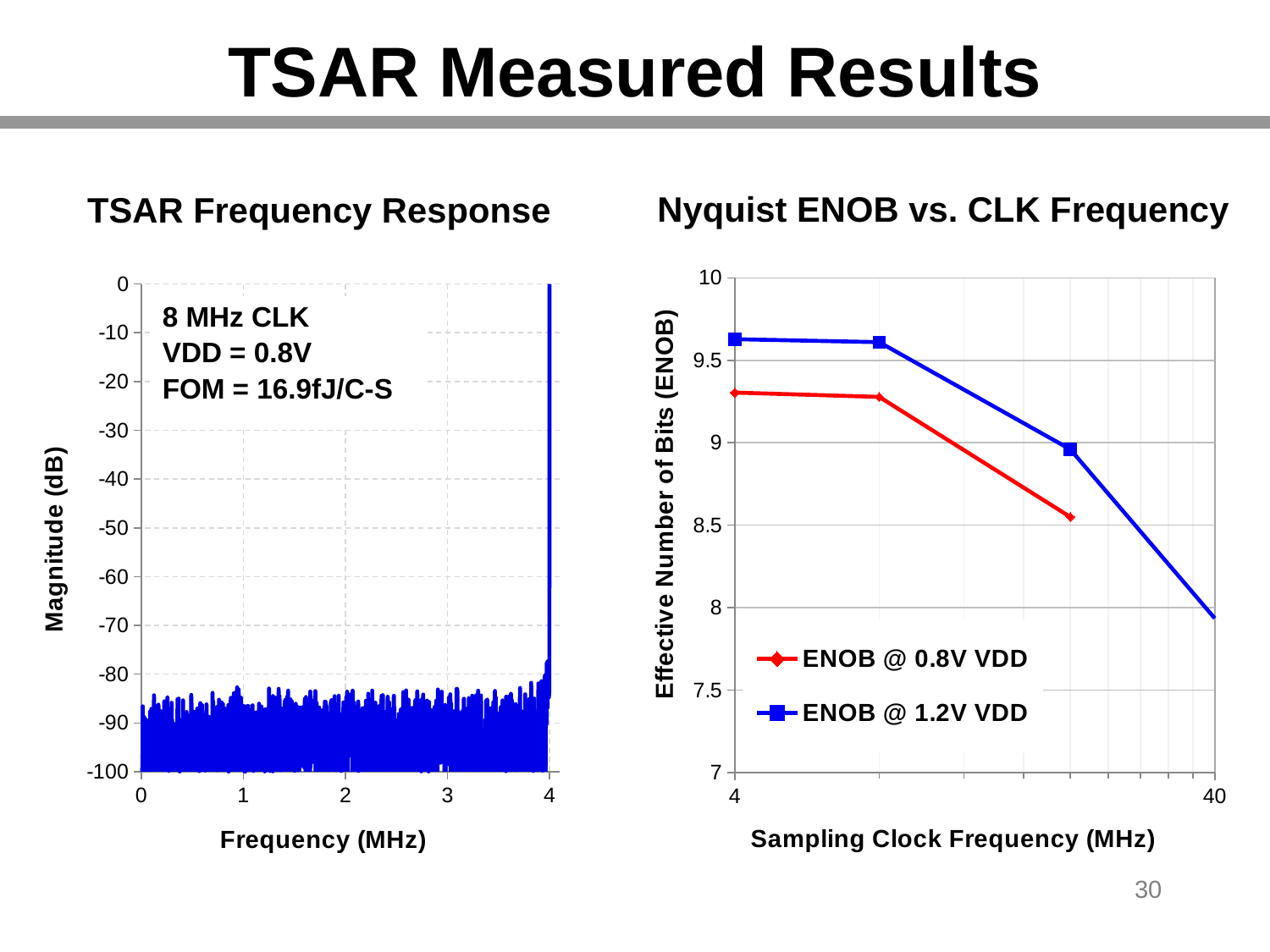
In the Nyquist ENOB vs. CLK Frequency chart, how many data points are plotted for the ENOB @ 0.8V VDD series? 3 In the Nyquist ENOB vs. CLK Frequency chart, is the ENOB @ 0.8V VDD value at 4 MHz greater or less than 9.5? less In the Nyquist ENOB vs. CLK Frequency chart, how many data points are plotted for the ENOB @ 1.2V VDD series? 4 In the Nyquist ENOB vs. CLK Frequency chart, is the ENOB @ 1.2V VDD value at 4 MHz greater or less than 9.5? greater What is the x-axis label of the TSAR Frequency Response chart? Frequency (MHz) In the TSAR Frequency Response chart, is the noise floor magnitude across most of the frequency range greater or less than -80 dB? less How many series does the legend of the Nyquist ENOB vs. CLK Frequency chart list? 2 What kind of chart is the Nyquist ENOB vs. CLK Frequency chart? line chart What clock frequency is stated in the annotation on the TSAR Frequency Response chart? 8 MHz CLK In the Nyquist ENOB vs. CLK Frequency chart, does ENOB rise or fall as the sampling clock frequency increases? fall In the Nyquist ENOB vs. CLK Frequency chart, at 4 MHz which series has the higher ENOB, ENOB @ 0.8V VDD or ENOB @ 1.2V VDD? ENOB @ 1.2V VDD